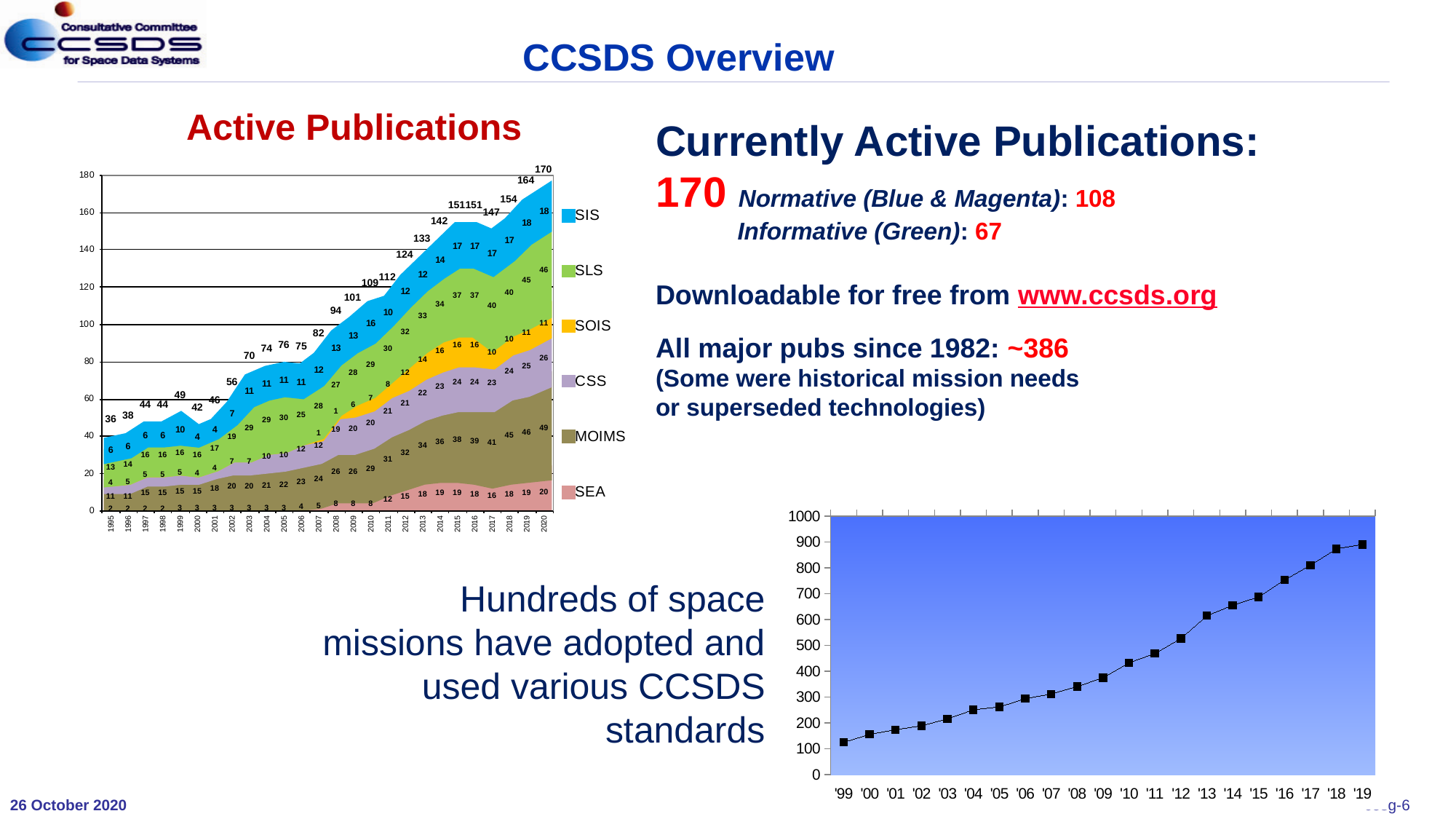
On the bottom-right line chart, is the value for '99 greater or less than 200? less On the Active Publications chart, which year has the lowest total of active publications? 1995 On the Active Publications chart, what is the MOIMS value in 2020? 49 On the Active Publications chart, what is the difference between the 2020 total and the 2019 total? 6 On the Active Publications chart, what is the total number of active publications in 2020? 170 On the Active Publications chart, what is the SLS value in 2020? 46 On the Active Publications chart, how many years are shown on the x axis? 26 On the Active Publications chart, do the total values generally rise or fall from 1995 to 2020? rise On the Active Publications chart, how many series does the legend list? 6 On the bottom-right line chart, is the value for '19 greater or less than 800? greater On the bottom-right line chart, how many data points are plotted? 21 What kind of chart is the chart at the bottom right of the slide? line chart